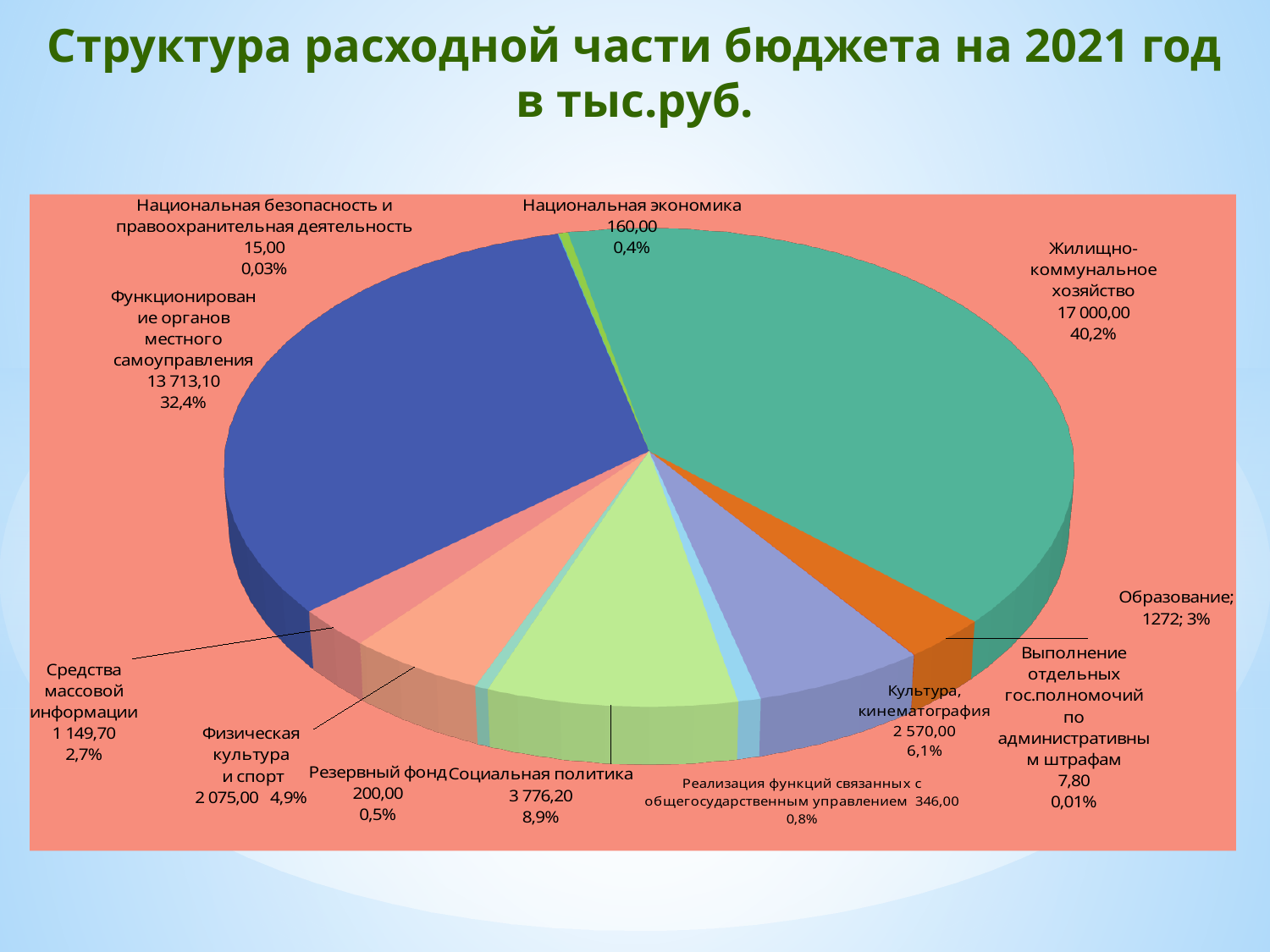
Which category has the smallest slice of the pie? Выполнение отдельных гос.полномочий по административным штрафам What share of the pie does Функционирование органов местного самоуправления represent? 32,4% Which is larger, the value for Средства массовой информации or the value for Образование? Образование What is the value for Жилищно-коммунальное хозяйство? 17 000,00 Which category has the largest slice of the pie? Жилищно-коммунальное хозяйство What is the value for Резервный фонд? 200,00 What is the difference between the values for Жилищно-коммунальное хозяйство and Функционирование органов местного самоуправления? 3 286,90 What is the value for Социальная политика? 3 776,20 What is the value for Культура, кинематография? 2 570,00 How many categories are shown in the pie chart? 12 What share of the pie does Физическая культура и спорт represent? 4,9% What kind of chart is shown on the slide? pie chart